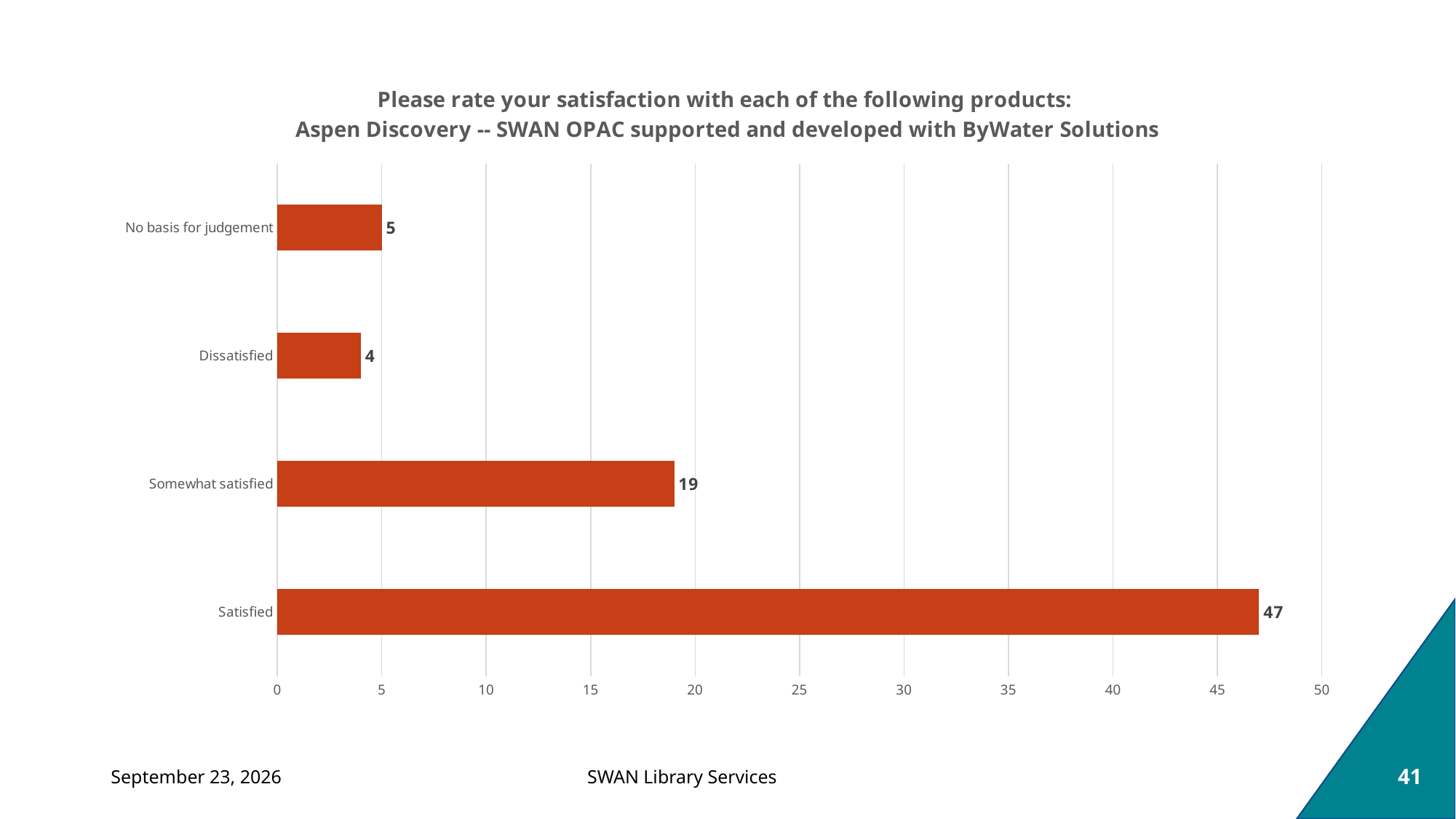
Which is larger, the value for No basis for judgement or the value for Dissatisfied? No basis for judgement Which category has the highest value? Satisfied Is the value for Satisfied greater or less than 45? greater What is the value for Somewhat satisfied? 19 What kind of chart is shown on the slide? bar chart What is the value for Satisfied? 47 What is the value for No basis for judgement? 5 What is the total of the Satisfied and Somewhat satisfied values? 66 Which category has the lowest value? Dissatisfied What is the value for Dissatisfied? 4 How many categories are shown in the chart? 4 What is the difference between the values for Satisfied and Somewhat satisfied? 28